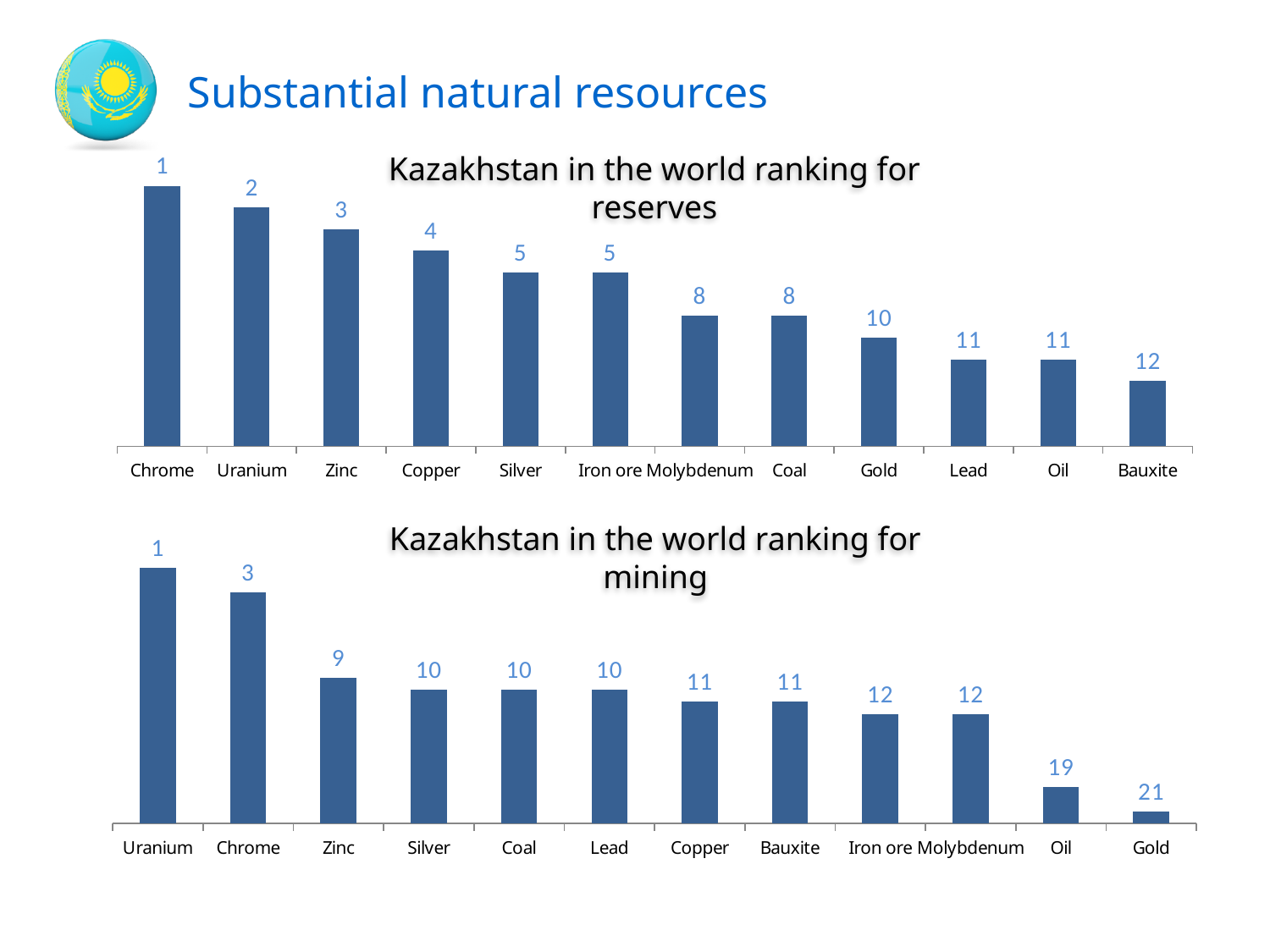
In the 'Kazakhstan in the world ranking for reserves' chart, what is the value for Gold? 10 In the 'Kazakhstan in the world ranking for mining' chart, what is the value for Oil? 19 How many categories are shown in the 'Kazakhstan in the world ranking for reserves' chart? 12 In the 'Kazakhstan in the world ranking for reserves' chart, what is the value for Copper? 4 In the 'Kazakhstan in the world ranking for mining' chart, what is the value for Zinc? 9 In the 'Kazakhstan in the world ranking for mining' chart, what is the difference between the values for Gold and Uranium? 20 In the 'Kazakhstan in the world ranking for reserves' chart, what is the difference between the values for Bauxite and Chrome? 11 In the 'Kazakhstan in the world ranking for mining' chart, which category has the smallest value? Uranium In the 'Kazakhstan in the world ranking for mining' chart, which has the larger value, Copper or Silver? Copper What kind of chart is the 'Kazakhstan in the world ranking for mining' chart? Bar chart In the 'Kazakhstan in the world ranking for reserves' chart, which category has the largest value? Bauxite